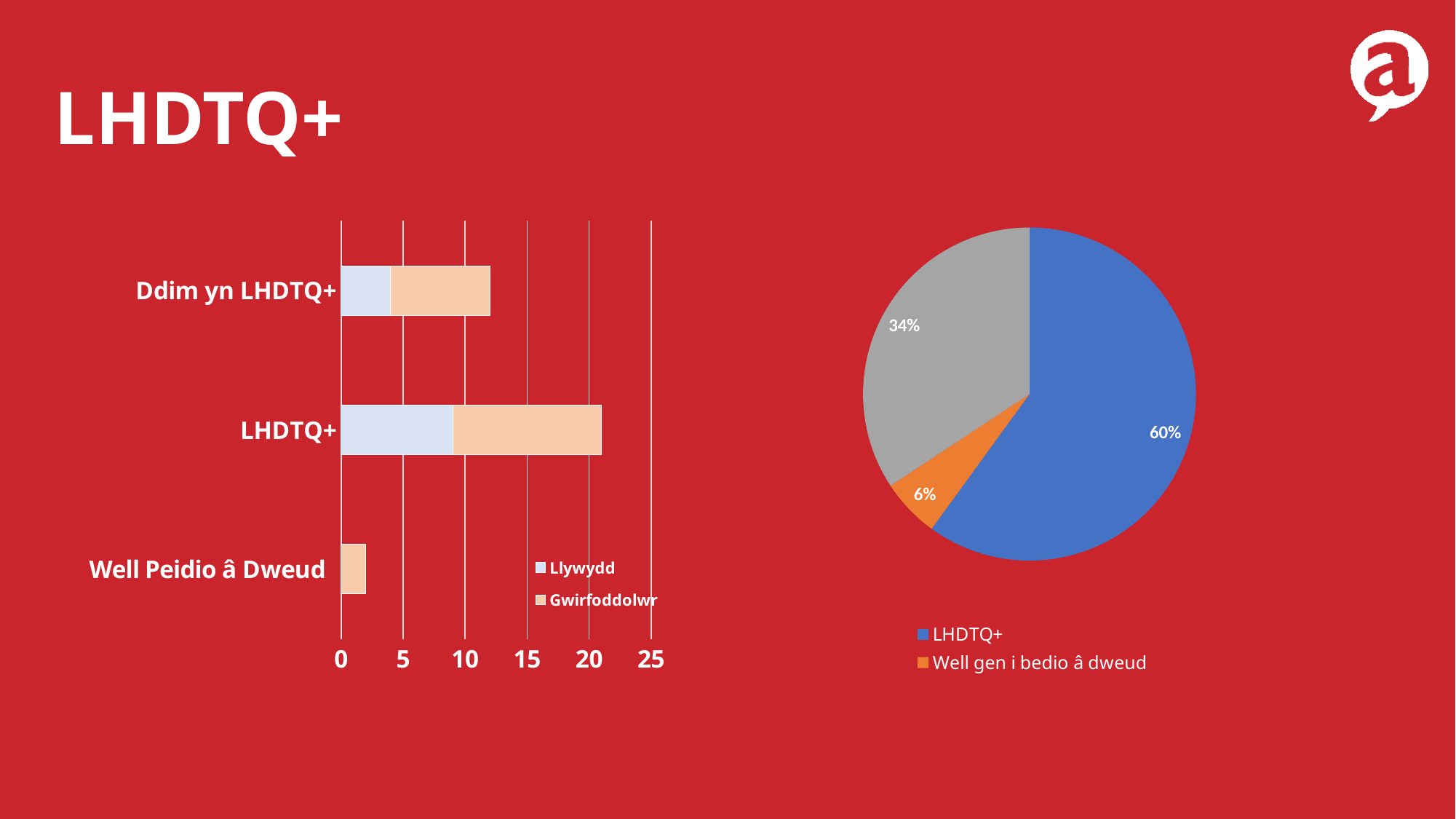
In the bar chart on the left, is the total bar for Ddim yn LHDTQ+ greater or less than 15? less In the bar chart on the left, which category has the longest total bar? LHDTQ+ In the bar chart on the left, is the total bar for LHDTQ+ greater or less than 20? greater In the bar chart on the left, how many series does the legend list? 2 In the bar chart on the left, which category has the shortest total bar? Well Peidio â Dweud What kind of chart is on the left of the slide? bar chart In the pie chart on the right, what share does the 'Well gen i bedio â dweud' slice have? 6% In the pie chart on the right, which slice is the largest? LHDTQ+ In the pie chart on the right, what share does the LHDTQ+ slice have? 60% In the bar chart on the left, how many categories are shown on the vertical axis? 3 What kind of chart is on the right of the slide? pie chart In the bar chart on the left, is the bar for Well Peidio â Dweud greater or less than 5? less